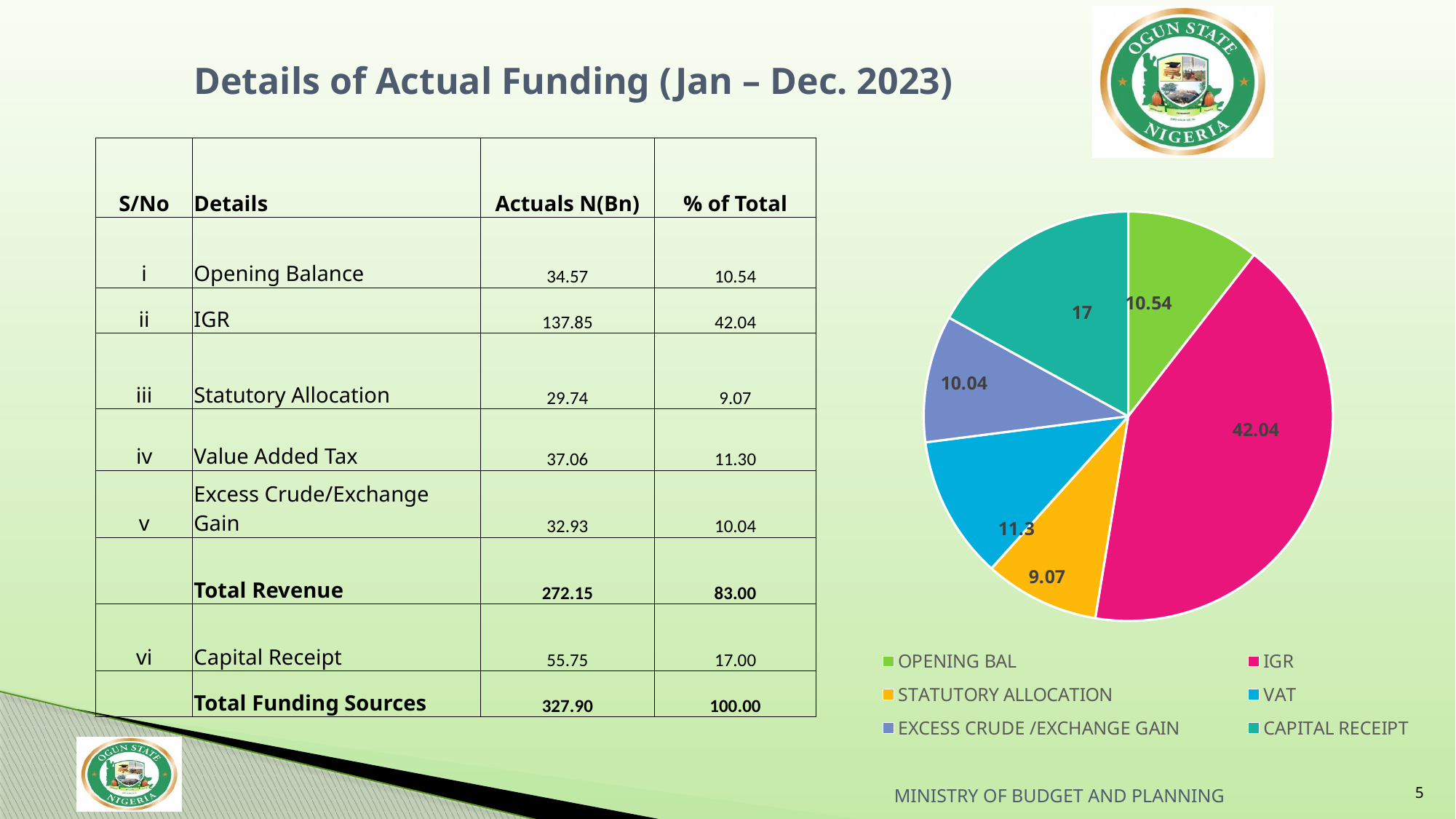
In the pie chart, what is the value labelled for IGR? 42.04 In the pie chart, what is the value labelled for CAPITAL RECEIPT? 17 In the pie chart, what is the difference between the IGR value and the CAPITAL RECEIPT value? 25.04 What type of chart is shown on the slide? pie chart How many slices does the pie chart have? 6 Which slice of the pie chart is the smallest? STATUTORY ALLOCATION What colour is the IGR slice in the pie chart? pink/magenta How many entries does the pie chart legend list? 6 In the pie chart, what is the value labelled for EXCESS CRUDE /EXCHANGE GAIN? 10.04 Which slice of the pie chart is the largest? IGR In the pie chart, what is the value labelled for VAT? 11.3 In the pie chart, which is larger: the VAT slice or the STATUTORY ALLOCATION slice? VAT